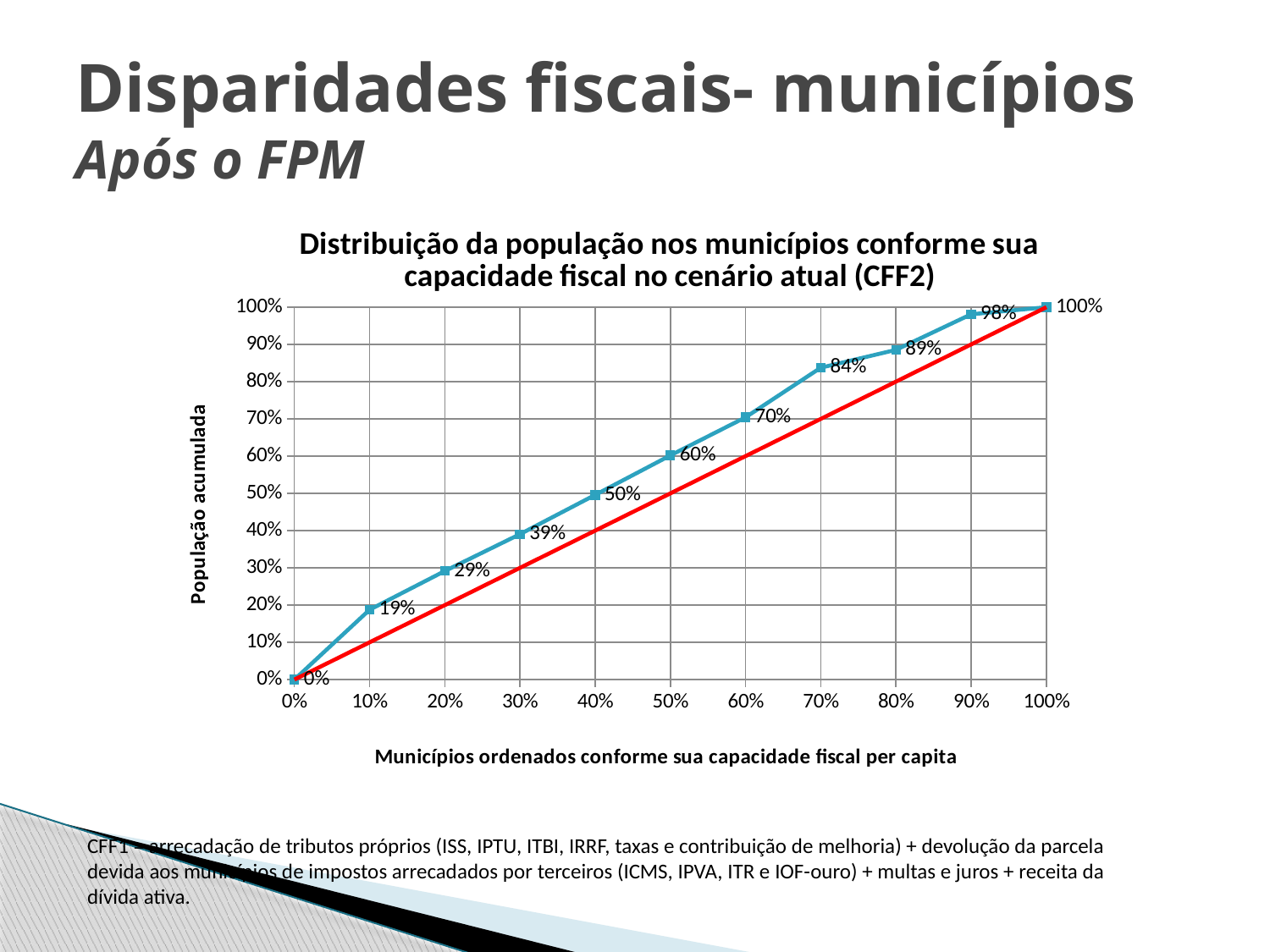
What is the accumulated population value at 70% of municipalities? 84% What is the accumulated population value at 90% of municipalities? 98% Which is larger: the accumulated population at 20% of municipalities or at 30%? 30% What is the accumulated population value at 10% of municipalities? 19% What is the label of the y axis? População acumulada What is the difference between the accumulated population at 70% and at 60% of municipalities? 14% What kind of chart is shown on the slide? Line chart What is the difference between the accumulated population at 60% and at 50% of municipalities? 10% What is the title of the chart? Distribuição da população nos municípios conforme sua capacidade fiscal no cenário atual (CFF2) What is the accumulated population value at 40% of municipalities? 50% Does the accumulated population rise or fall as the share of municipalities increases along the x axis? Rises How many labelled data points does the blue line have? 11